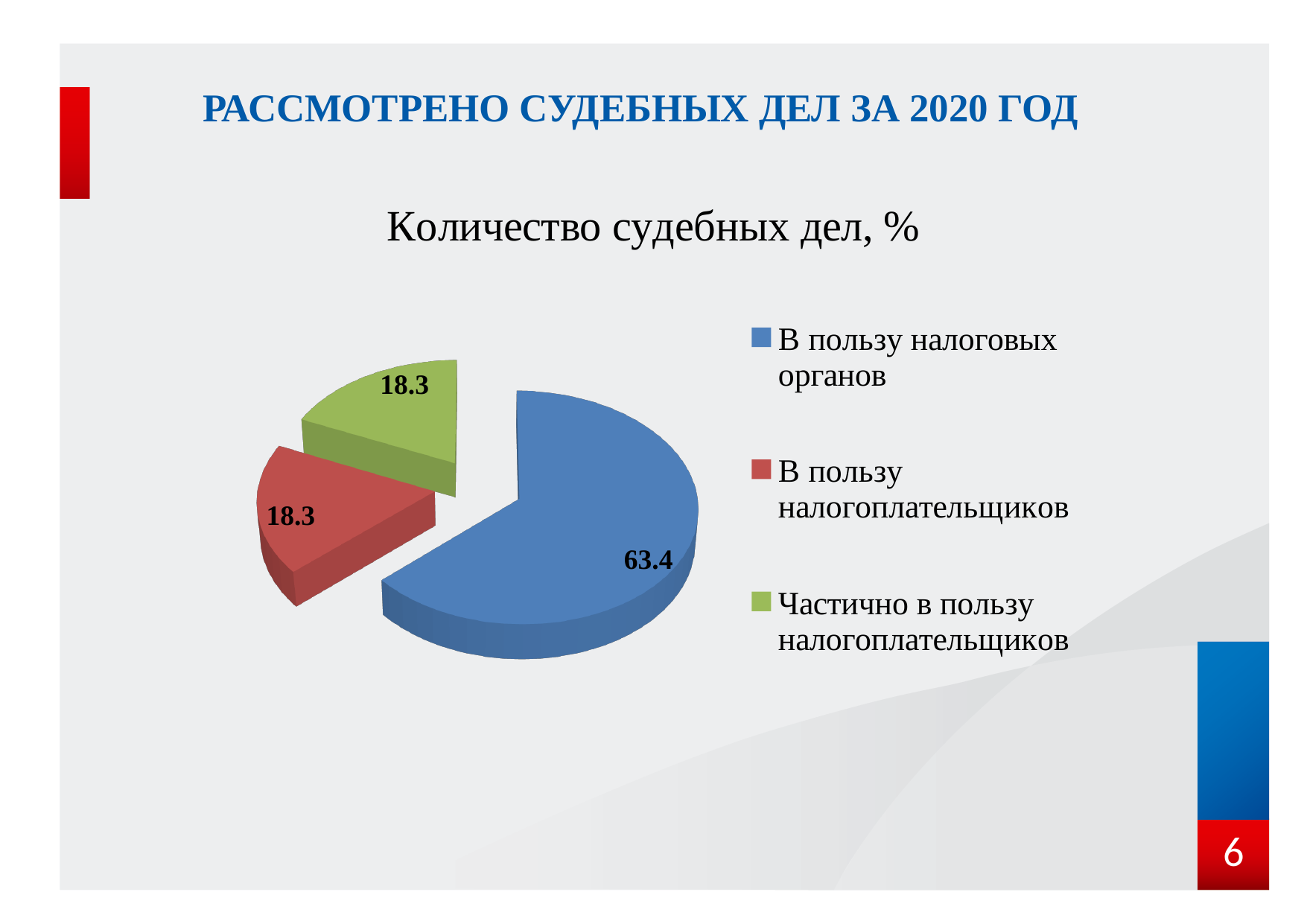
How many slices does the pie chart have? 3 What is the difference between the values for 'В пользу налоговых органов' and 'В пользу налогоплательщиков'? 45.1 What is the value for 'В пользу налогоплательщиков' in the pie chart? 18.3 What share of the pie does the 'В пользу налоговых органов' slice represent? 63.4% What kind of chart is shown on the slide? Pie chart Which colour represents 'Частично в пользу налогоплательщиков' in the legend? Green Which category has the largest slice in the pie chart? В пользу налоговых органов Which is larger: the value for 'В пользу налоговых органов' or the value for 'Частично в пользу налогоплательщиков'? В пользу налоговых органов What is the value for 'Частично в пользу налогоплательщиков' in the pie chart? 18.3 Is the value for 'В пользу налоговых органов' greater or less than 50? greater What is the title of the pie chart? Количество судебных дел, % What is the value for 'В пользу налоговых органов' in the pie chart? 63.4